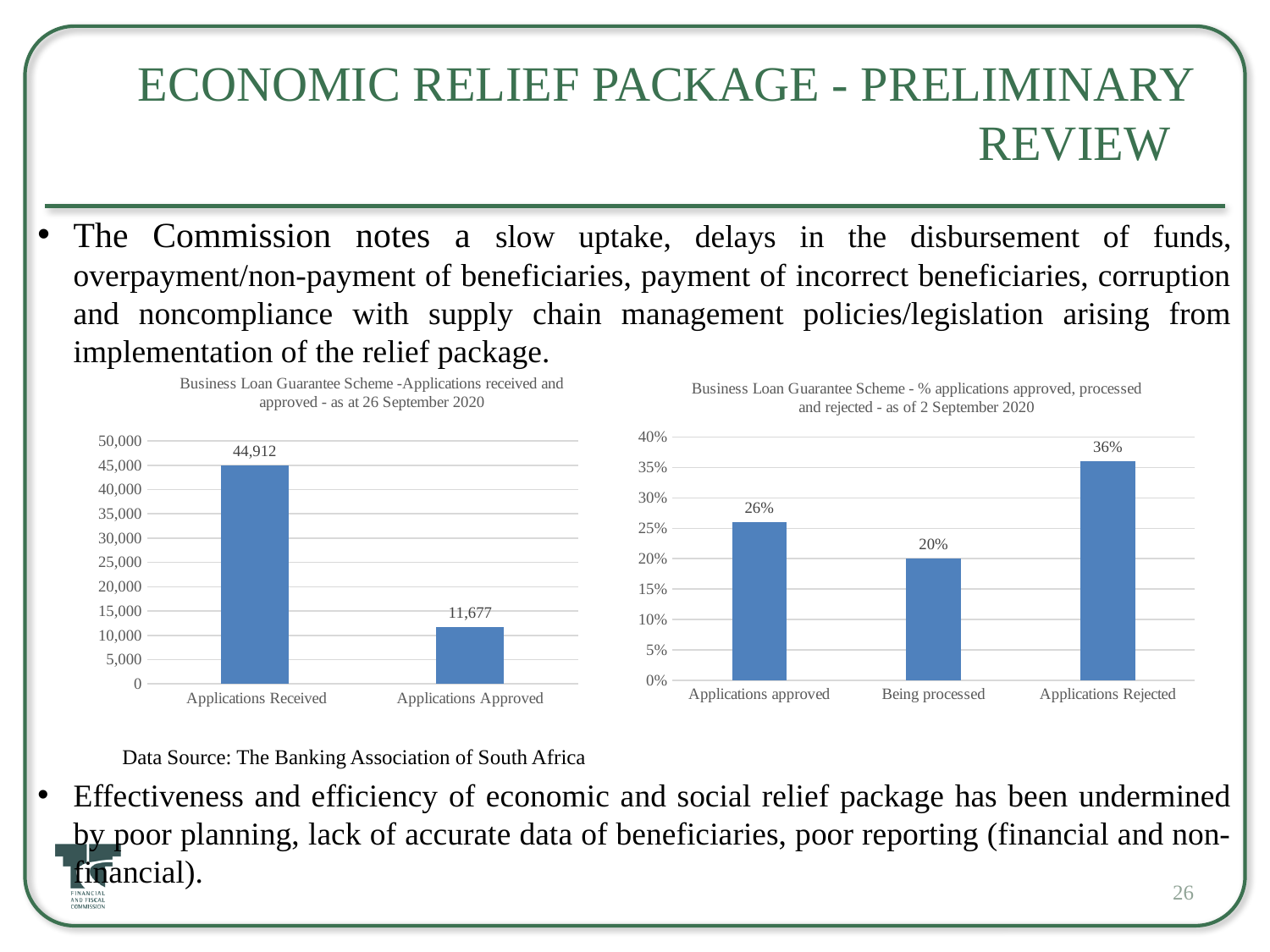
In the left chart (Applications received and approved), what is the value for Applications Received? 44,912 In the right chart (% applications approved, processed and rejected), which category has the lowest value? Being processed In the right chart (% applications approved, processed and rejected), what is the value for Applications Rejected? 36% In the right chart (% applications approved, processed and rejected), which category has the highest value? Applications Rejected In the right chart (% applications approved, processed and rejected), what is the value for Being processed? 20% In the left chart (Applications received and approved), what kind of chart is it? Bar chart In the right chart (% applications approved, processed and rejected), which is larger: Applications approved or Being processed? Applications approved In the right chart (% applications approved, processed and rejected), what is the difference between Applications Rejected and Applications approved? 10% In the left chart (Applications received and approved), what is the value for Applications Approved? 11,677 In the left chart (Applications received and approved), what is the difference between Applications Received and Applications Approved? 33,235 In the right chart (% applications approved, processed and rejected), how many categories are shown? 3 In the left chart (Applications received and approved), how many categories are shown? 2